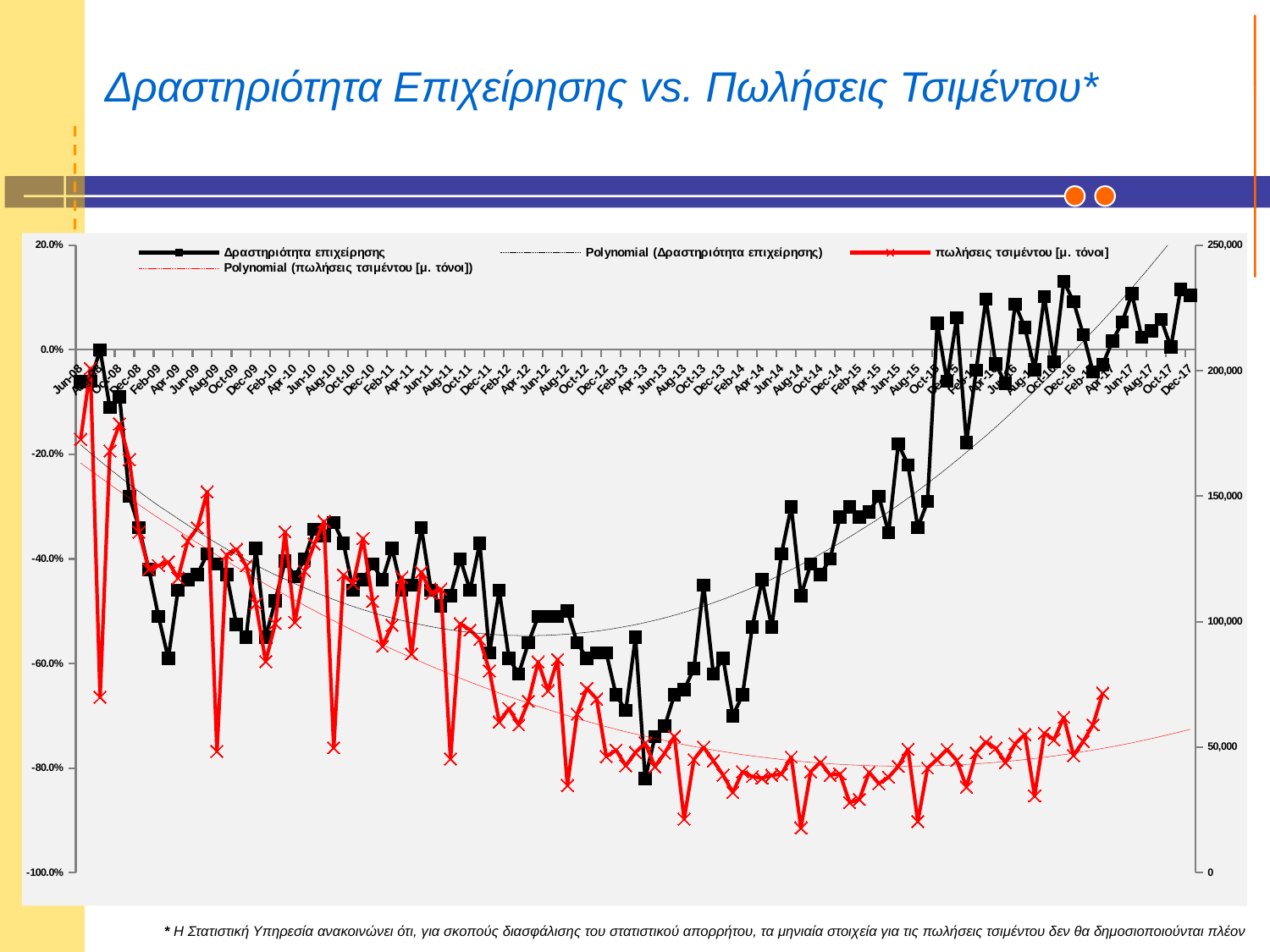
Which is larger for Δραστηριότητα επιχείρησης: the value at Apr-13 or the value at Dec-17? Dec-17 What is the title of the slide? Δραστηριότητα Επιχείρησης vs. Πωλήσεις Τσιμέντου* Is the value of Δραστηριότητα επιχείρησης at Dec-17 greater or less than 0.0%? greater Is the value of Δραστηριότητα επιχείρησης at Apr-13 greater or less than -60.0%? less At which x-axis date does Δραστηριότητα επιχείρησης reach its lowest value? Apr-13 What kind of chart is shown on the slide? line chart What is the highest value shown on the right-hand vertical axis? 250,000 Does Δραστηριότητα επιχείρησης rise or fall overall between Apr-13 and Dec-17? rise Is the value of πωλήσεις τσιμέντου [μ. τόνοι] at Jun-08 greater or less than 150,000? greater How many series does the chart legend list? 4